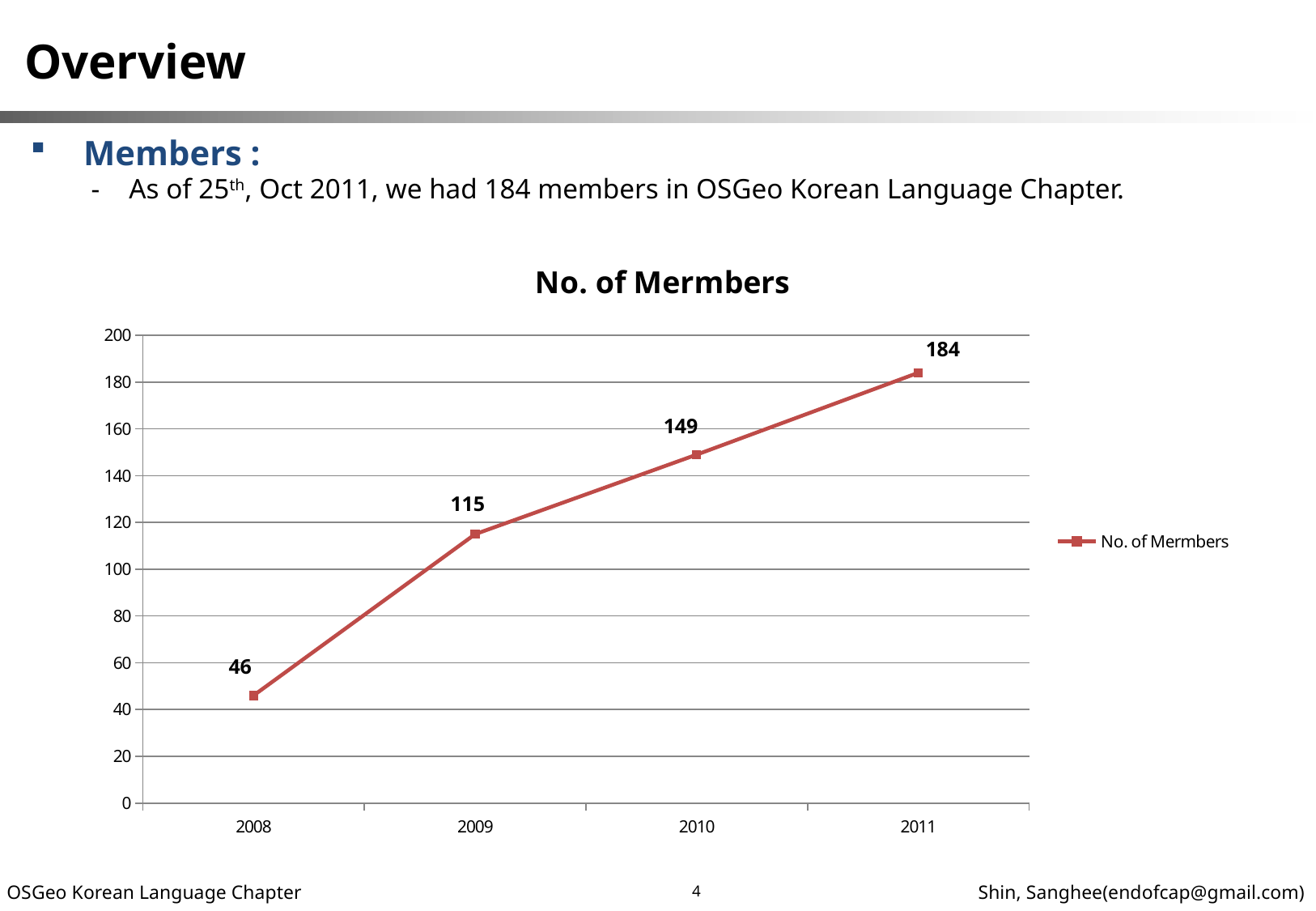
Which year has the lowest number of members? 2008 Which year has the highest number of members? 2011 What is the difference in the number of members between 2009 and 2008? 69 Do the values rise or fall from 2008 to 2011? rise What is the number of members in 2008? 46 Which year has more members, 2009 or 2010? 2010 How many series does the legend list? 1 What is the number of members in 2011? 184 How many years are plotted on the chart? 4 What is the difference in the number of members between 2011 and 2010? 35 What is the number of members in 2009? 115 What kind of chart is shown on the slide? line chart